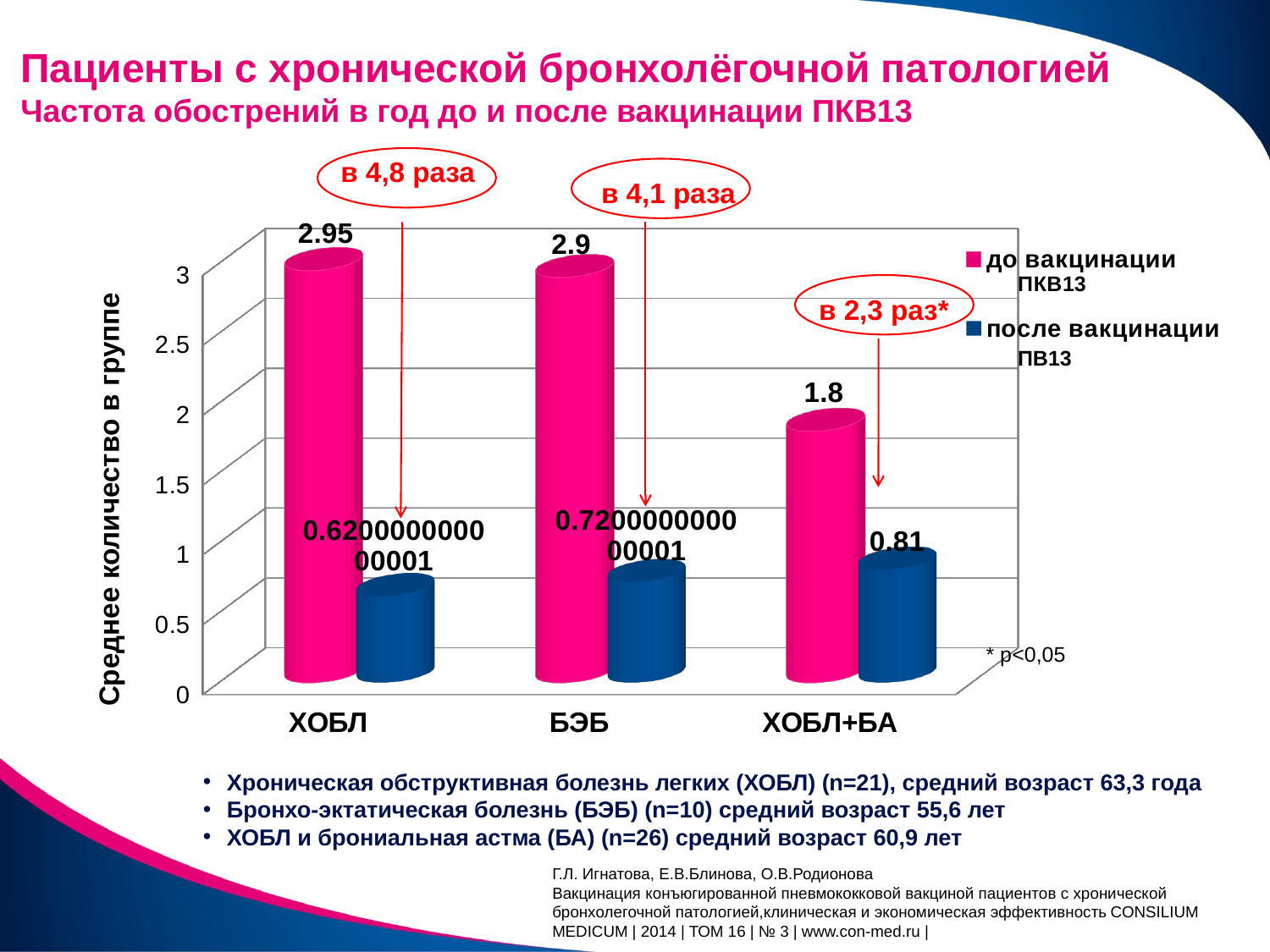
How many patient groups (categories) are shown on the x axis? 3 What is the title of the vertical axis? Среднее количество в группе What is the value for БЭБ in the 'до вакцинации ПКВ13' series? 2.9 Which category has the highest value in the 'после вакцинации ПВ13' series? ХОБЛ+БА What is the value for ХОБЛ in the 'до вакцинации ПКВ13' series? 2.95 Which category has the lowest value in the 'до вакцинации ПКВ13' series? ХОБЛ+БА What is the value for ХОБЛ+БА in the 'до вакцинации ПКВ13' series? 1.8 Is the 'после вакцинации ПВ13' value for ХОБЛ greater or less than 1? less What kind of chart is shown on the slide? bar chart What is the difference between the 'до вакцинации ПКВ13' values for ХОБЛ and ХОБЛ+БА? 1.15 What is the value for ХОБЛ+БА in the 'после вакцинации ПВ13' series? 0.81 How many series does the legend list? 2